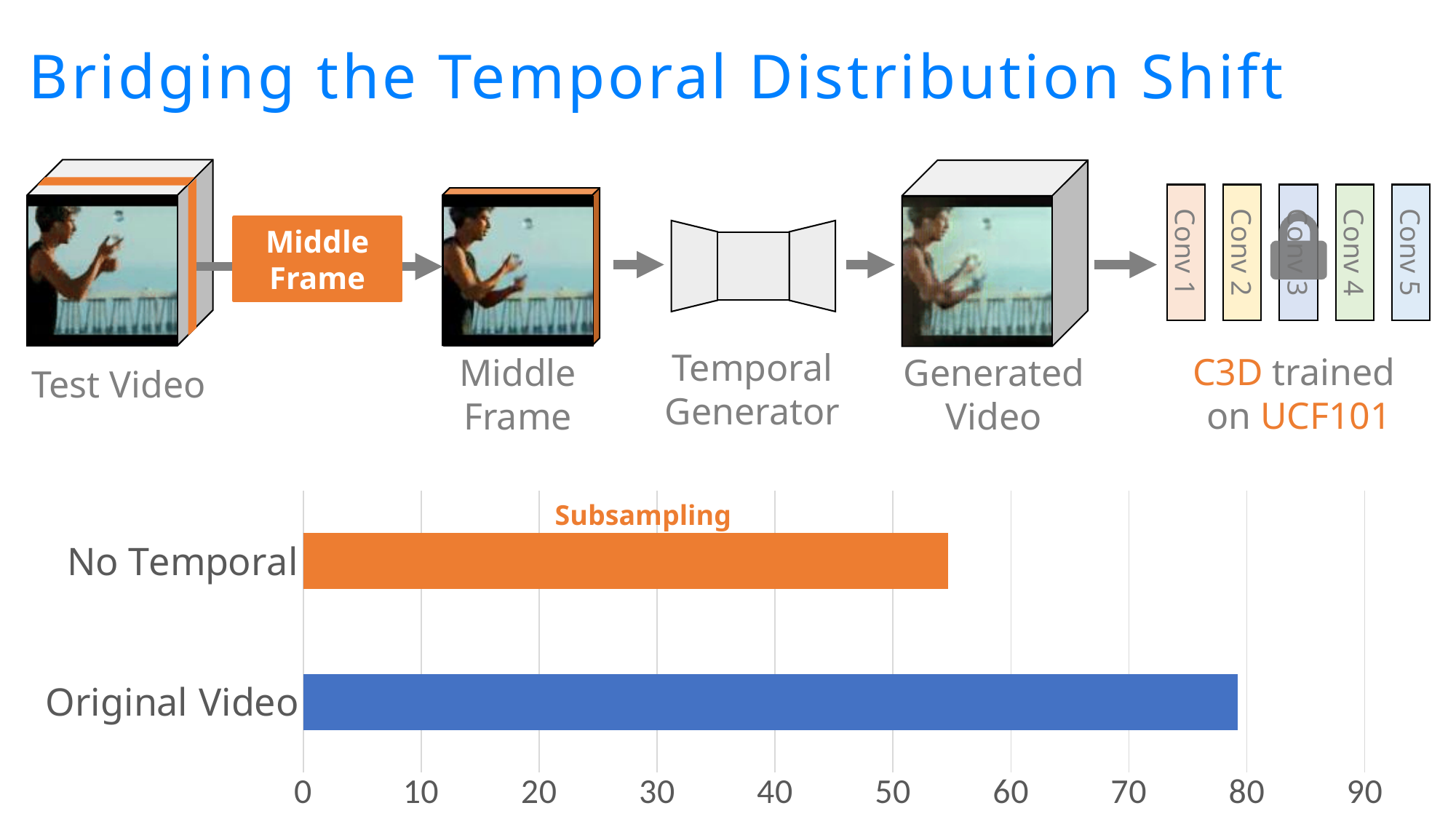
Is the value for No Temporal greater or less than 50? greater Is the value for Original Video greater or less than 70? greater Which category has the lowest value in the bar chart? No Temporal Which is larger in the bar chart, the value for No Temporal or the value for Original Video? Original Video Is the value for Original Video greater or less than 90? less How many categories does the bar chart show? 2 What is the highest tick value shown on the x axis of the bar chart? 90 What colour is the bar for Original Video? blue Which category has the highest value in the bar chart? Original Video What kind of chart is shown at the bottom of the slide? bar chart